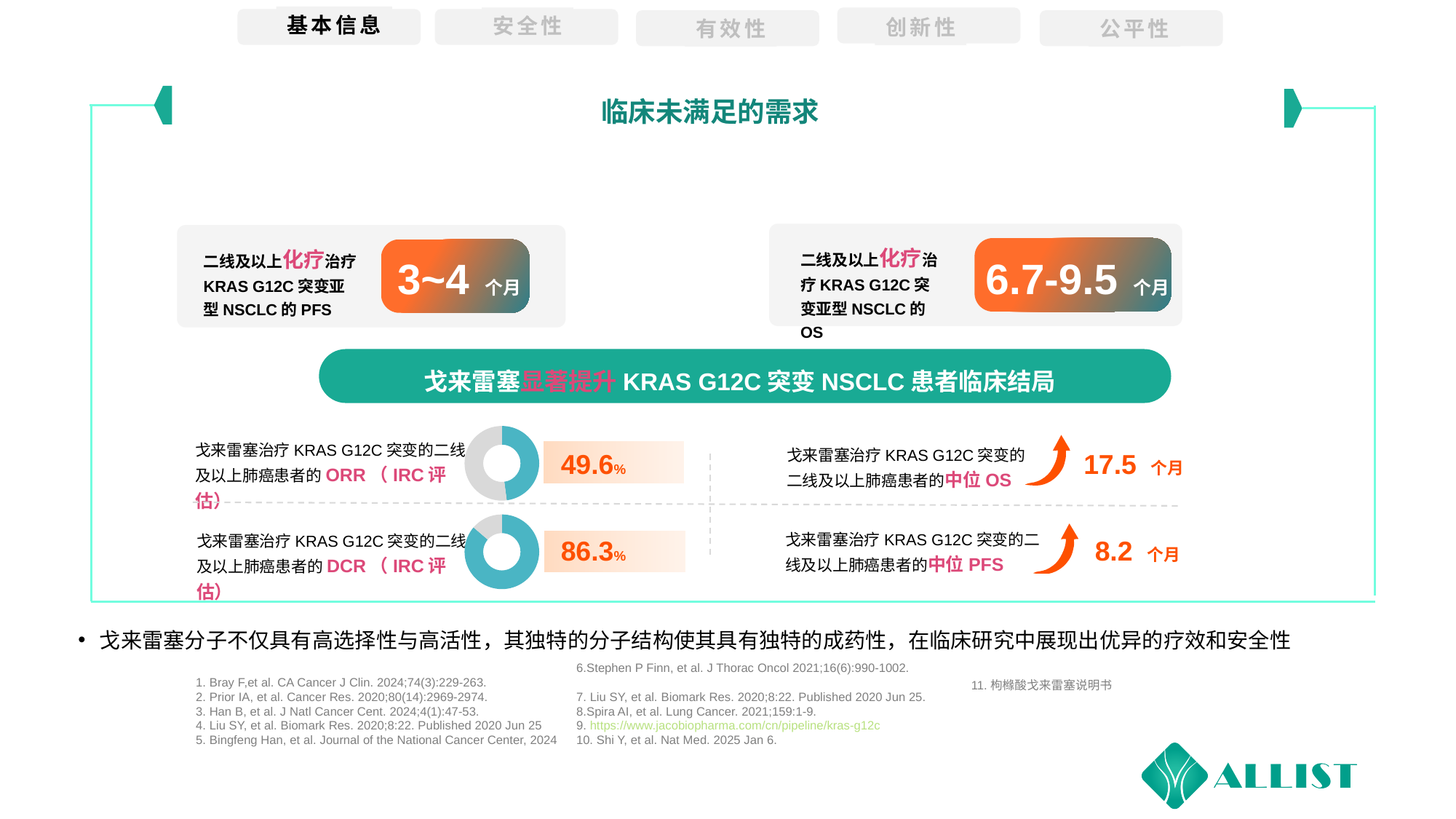
According to the slide, what is the median OS (中位 OS) for 戈来雷塞 in second-line and later KRAS G12C mutant lung cancer patients? 17.5 个月 Which is larger, the ORR shown in the upper donut chart or the DCR shown in the lower donut chart? DCR What share of the lower donut chart is filled (teal) for the DCR? 86.3% What type of chart is used to show the ORR and DCR values on the slide? donut (pie) chart Is the ORR value shown in the upper donut chart greater or less than 50%? less In the upper donut chart, what is the ORR (IRC 评估) for 戈来雷塞 in second-line and later KRAS G12C mutant lung cancer patients? 49.6% Is the DCR value shown in the lower donut chart greater or less than 80%? greater In the lower donut chart, what is the DCR (IRC 评估) for 戈来雷塞 in second-line and later KRAS G12C mutant lung cancer patients? 86.3% According to the slide, what is the median PFS (中位 PFS) for 戈来雷塞 in second-line and later KRAS G12C mutant lung cancer patients? 8.2 个月 How many donut charts are shown on the slide? 2 What colour is the filled portion of the donut charts representing ORR and DCR? teal (blue-green) What is the difference between the DCR (86.3%) and the ORR (49.6%) shown in the two donut charts? 36.7%